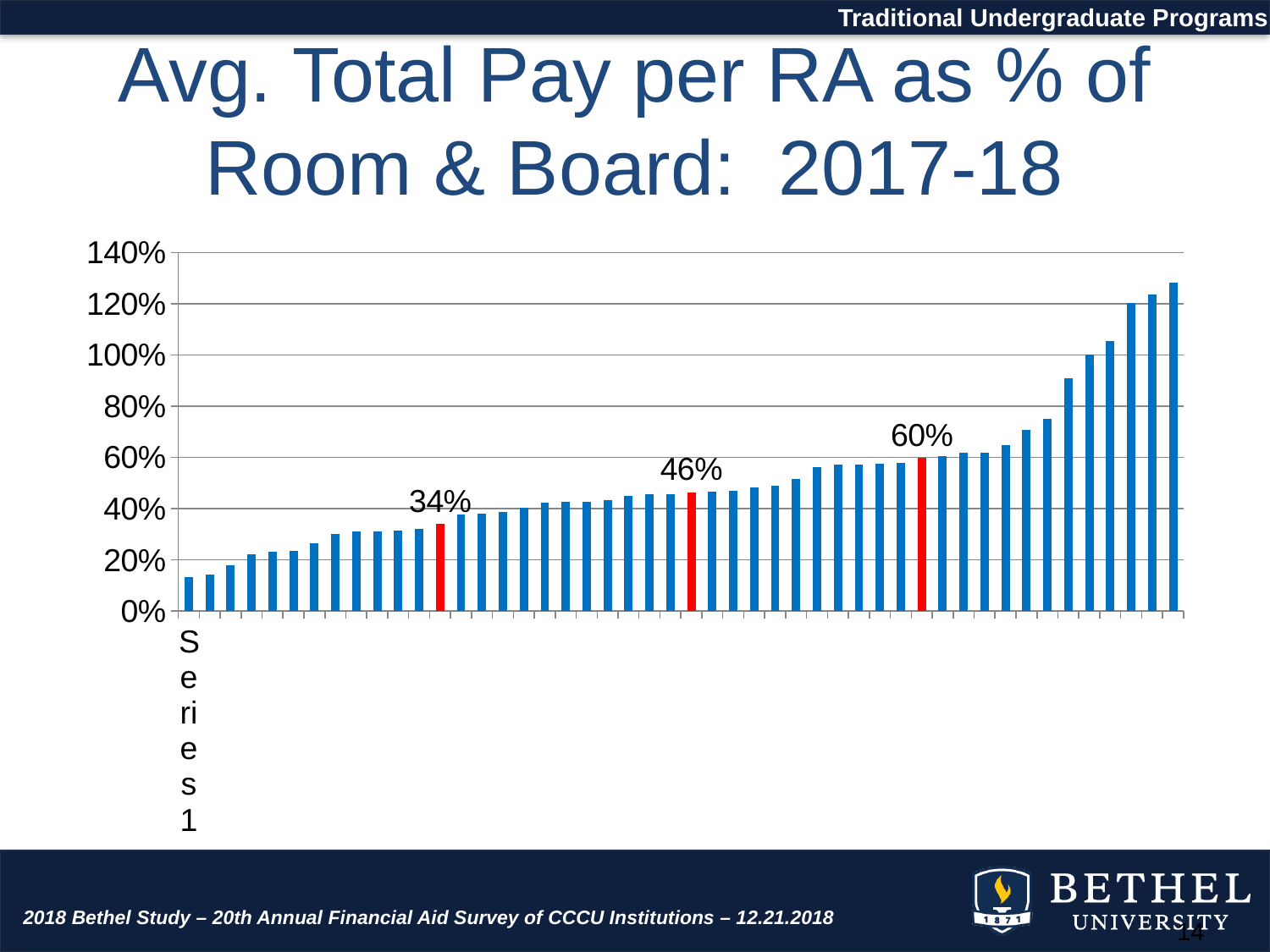
What value is labeled on the rightmost red bar? 60% What is the title of the chart on the slide? Avg. Total Pay per RA as % of Room & Board: 2017-18 How many bars are highlighted in red? 3 Do the bar values rise or fall from left to right along the x axis? rise What value is labeled on the middle red bar? 46% Which of the three labeled values is the highest? 60% Is the value of the tallest bar on the far right greater or less than 120%? greater What value is labeled on the leftmost red bar? 34% What kind of chart is shown on the slide? bar chart What is the difference between the labeled values 60% and 34%? 26%